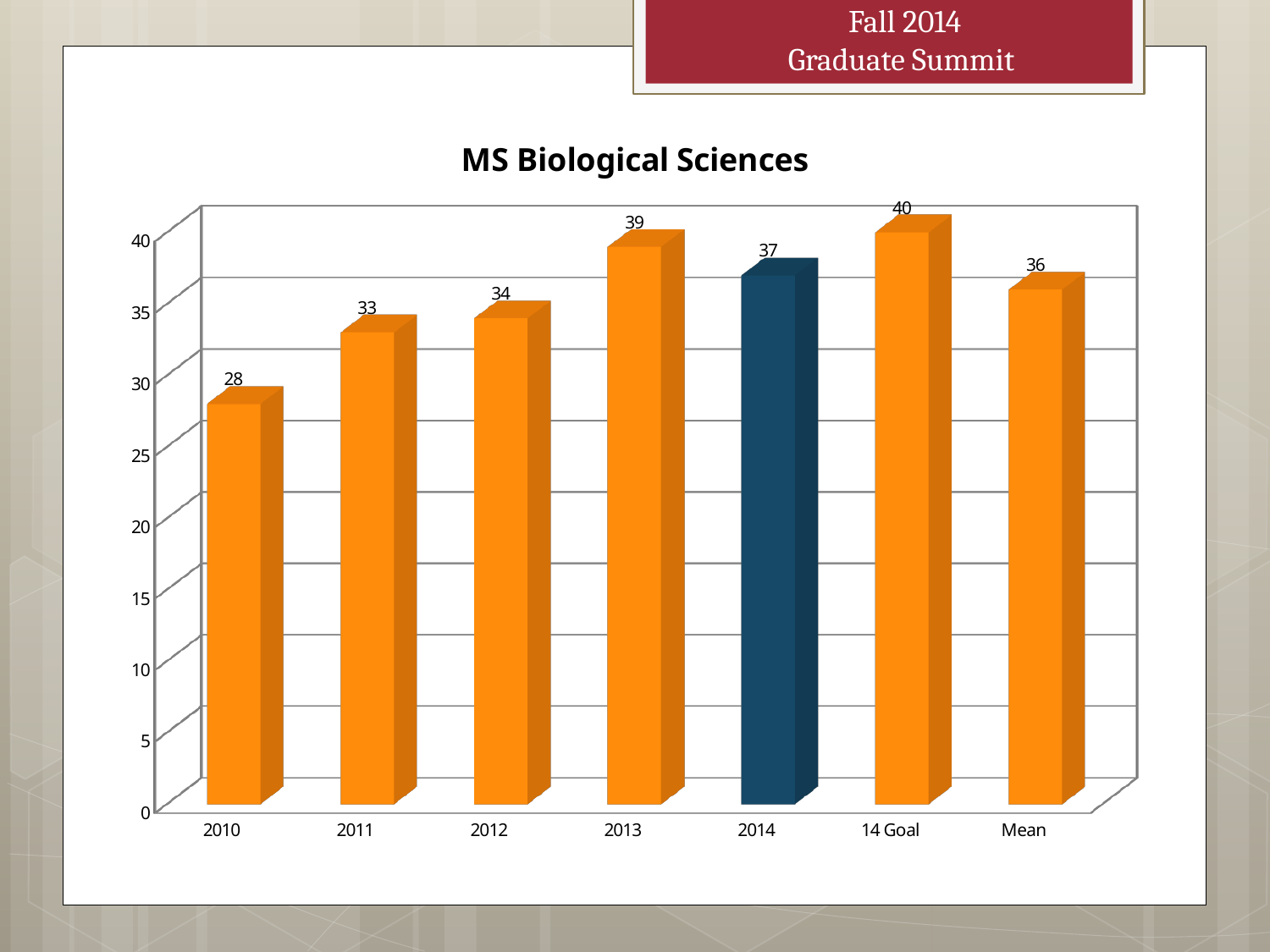
What is the difference between the 14 Goal value and the 2014 value? 3 What is the value for Mean? 36 What is the value for 2014? 37 What is the value for 14 Goal? 40 What is the title of the chart? MS Biological Sciences Which is larger, the value for 2011 or the value for 2014? 2014 Which category has the lowest value? 2010 What kind of chart is this? Bar chart Which category has the highest value? 14 Goal How many categories are shown on the x axis? 7 What is the value for 2010? 28 What is the difference between the values for 2013 and 2012? 5